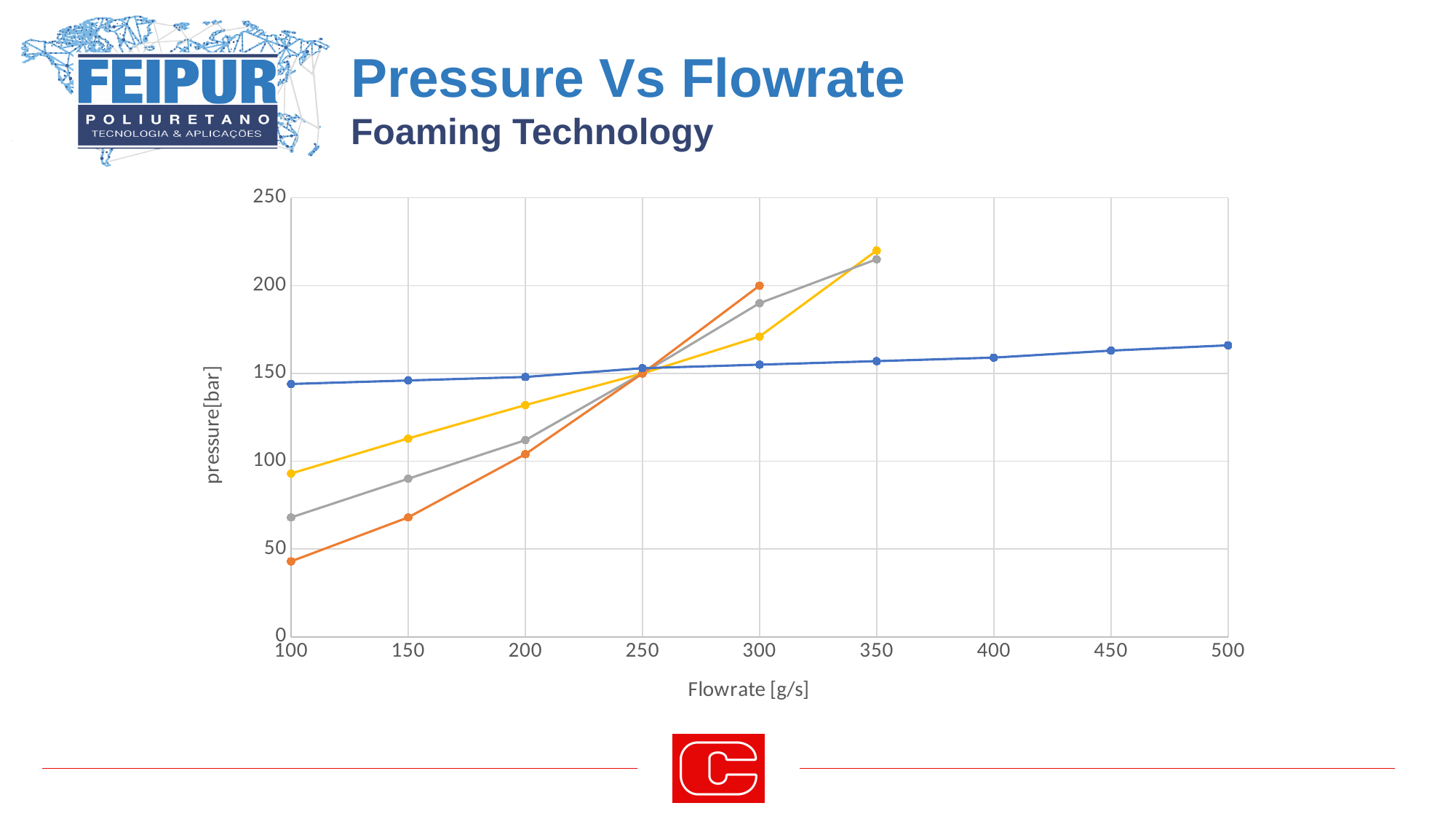
Is the value of the blue line at a flowrate of 500 greater or less than 150? greater At a flowrate of 350, which line has the larger value, the yellow line or the blue line? yellow line What is the label of the horizontal axis? Flowrate [g/s] What is the label of the vertical axis? pressure[bar] Does the blue line rise or fall as flowrate increases from 100 to 500? rises Is the value of the orange line at a flowrate of 100 greater or less than 50? less What kind of chart is shown on the slide? line chart How many data points does the orange line have? 5 At a flowrate of 100, which line has the larger value, the blue line or the orange line? blue line Is the value of the yellow line at a flowrate of 350 greater or less than 200? greater How many data points does the blue line have? 9 What is the value of the orange line at a flowrate of 300? 200